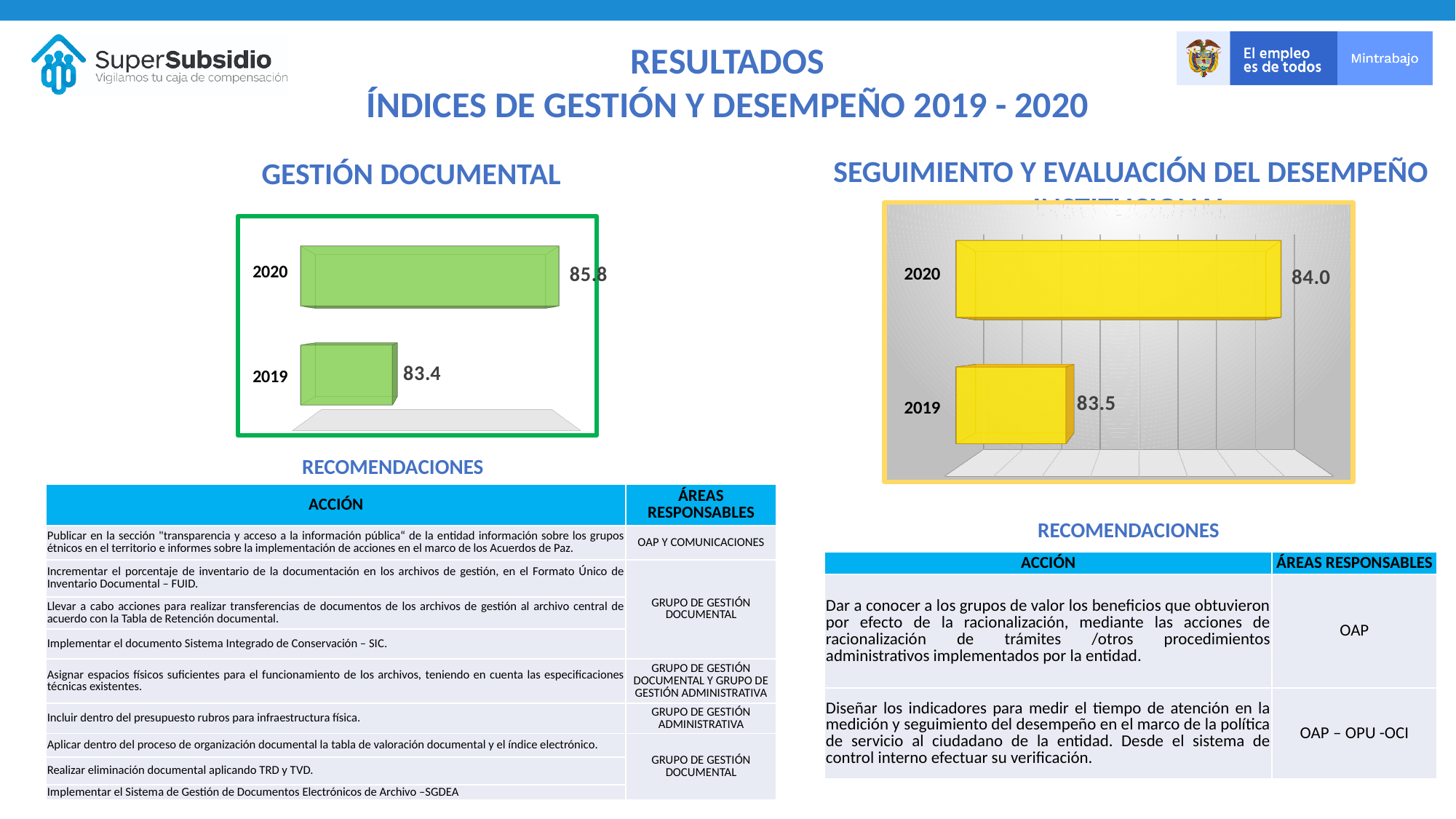
In the SEGUIMIENTO Y EVALUACIÓN DEL DESEMPEÑO chart, what is the value for 2020? 84.0 Is the 2020 value in the GESTIÓN DOCUMENTAL chart larger or smaller than the 2020 value in the SEGUIMIENTO Y EVALUACIÓN DEL DESEMPEÑO chart? larger In the SEGUIMIENTO Y EVALUACIÓN DEL DESEMPEÑO chart, what is the difference between the 2020 and 2019 values? 0.5 In the SEGUIMIENTO Y EVALUACIÓN DEL DESEMPEÑO chart, which year has the lower value? 2019 In the GESTIÓN DOCUMENTAL chart, what is the value for 2019? 83.4 In the SEGUIMIENTO Y EVALUACIÓN DEL DESEMPEÑO chart, what is the value for 2019? 83.5 In the GESTIÓN DOCUMENTAL chart, what is the value for 2020? 85.8 In the GESTIÓN DOCUMENTAL chart, which year has the higher value? 2020 What colour are the bars in the SEGUIMIENTO Y EVALUACIÓN DEL DESEMPEÑO chart? Yellow How many bars are shown in the GESTIÓN DOCUMENTAL chart? 2 In the GESTIÓN DOCUMENTAL chart, what is the difference between the 2020 and 2019 values? 2.4 What type of chart is the GESTIÓN DOCUMENTAL chart? Bar chart